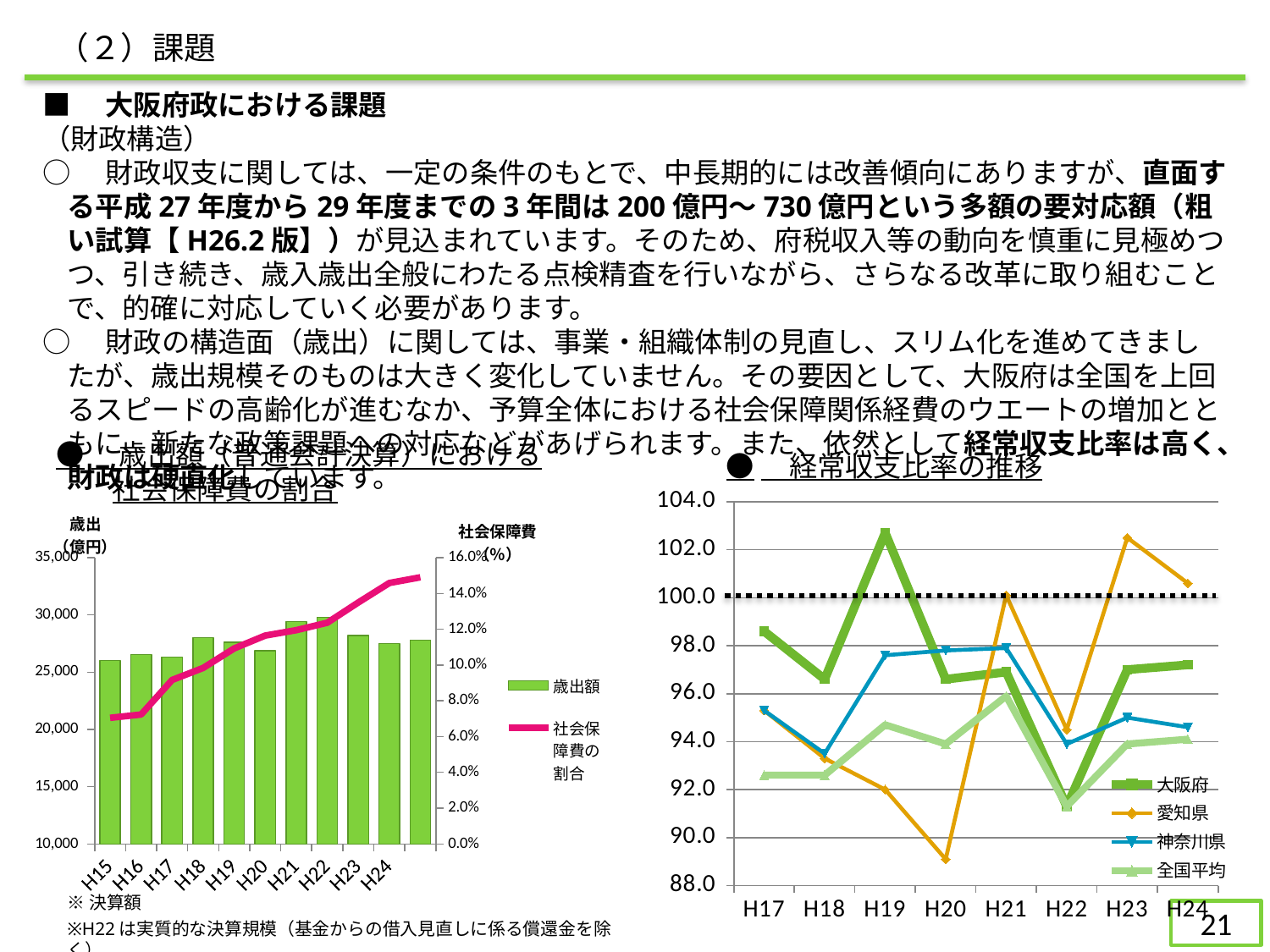
In the left chart (歳出額における社会保障費の割合), is the 社会保障費の割合 value for H24 greater or less than 14.0%? greater In the left chart (歳出額における社会保障費の割合), how many years are shown on the x axis? 10 In the left chart (歳出額における社会保障費の割合), does the 社会保障費の割合 line rise or fall from H15 to H24? rise In the right chart (経常収支比率の推移), how many series does the legend list? 4 In the right chart (経常収支比率の推移), is the value for 愛知県 in H20 greater or less than 90.0? less In the right chart (経常収支比率の推移), which series has the highest value in H23? 愛知県 In the right chart (経常収支比率の推移), in which year does 大阪府 reach its highest value? H19 In the right chart (経常収支比率の推移), in H20, which is larger: 神奈川県 or 愛知県? 神奈川県 In the right chart (経常収支比率の推移), is the value for 大阪府 in H19 greater or less than 102.0? greater In the right chart (経常収支比率の推移), how many years are plotted on the x axis? 8 What kind of chart is the right chart (経常収支比率の推移)? line chart In the right chart (経常収支比率の推移), in which year does 愛知県 reach its lowest value? H20